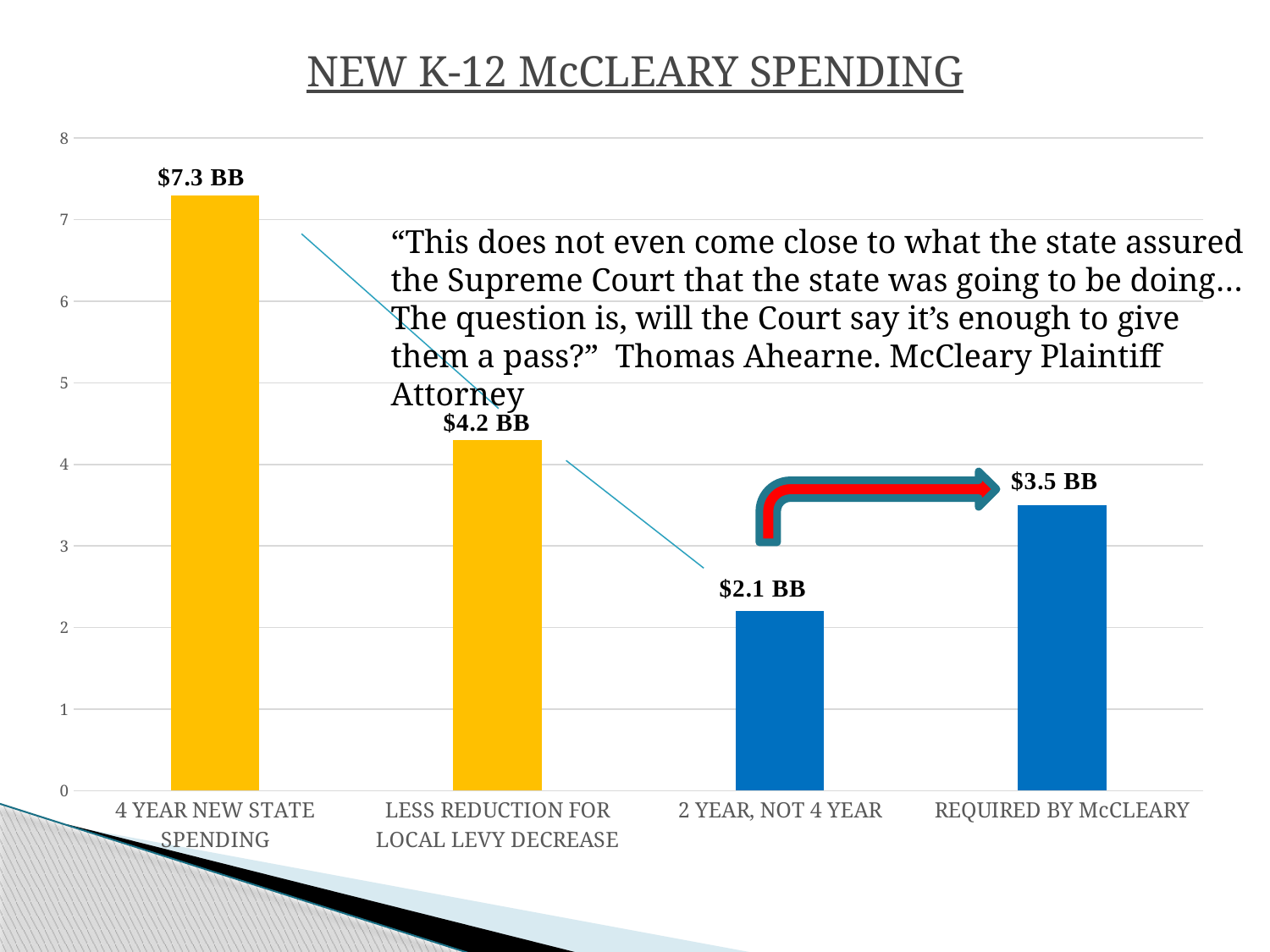
What is the value for 4 YEAR NEW STATE SPENDING? $7.3 BB How many categories are shown on the chart? 4 What is the difference between the values for 4 YEAR NEW STATE SPENDING and LESS REDUCTION FOR LOCAL LEVY DECREASE? $3.1 BB What kind of chart is shown on the slide? Bar chart What is the title of the chart? NEW K-12 McCLEARY SPENDING What is the value for 2 YEAR, NOT 4 YEAR? $2.1 BB Which is larger, the value for REQUIRED BY McCLEARY or the value for 2 YEAR, NOT 4 YEAR? REQUIRED BY McCLEARY What is the difference between the values for REQUIRED BY McCLEARY and 2 YEAR, NOT 4 YEAR? $1.4 BB Which category has the lowest value? 2 YEAR, NOT 4 YEAR What is the value for LESS REDUCTION FOR LOCAL LEVY DECREASE? $4.2 BB What is the value for REQUIRED BY McCLEARY? $3.5 BB Which category has the highest value? 4 YEAR NEW STATE SPENDING